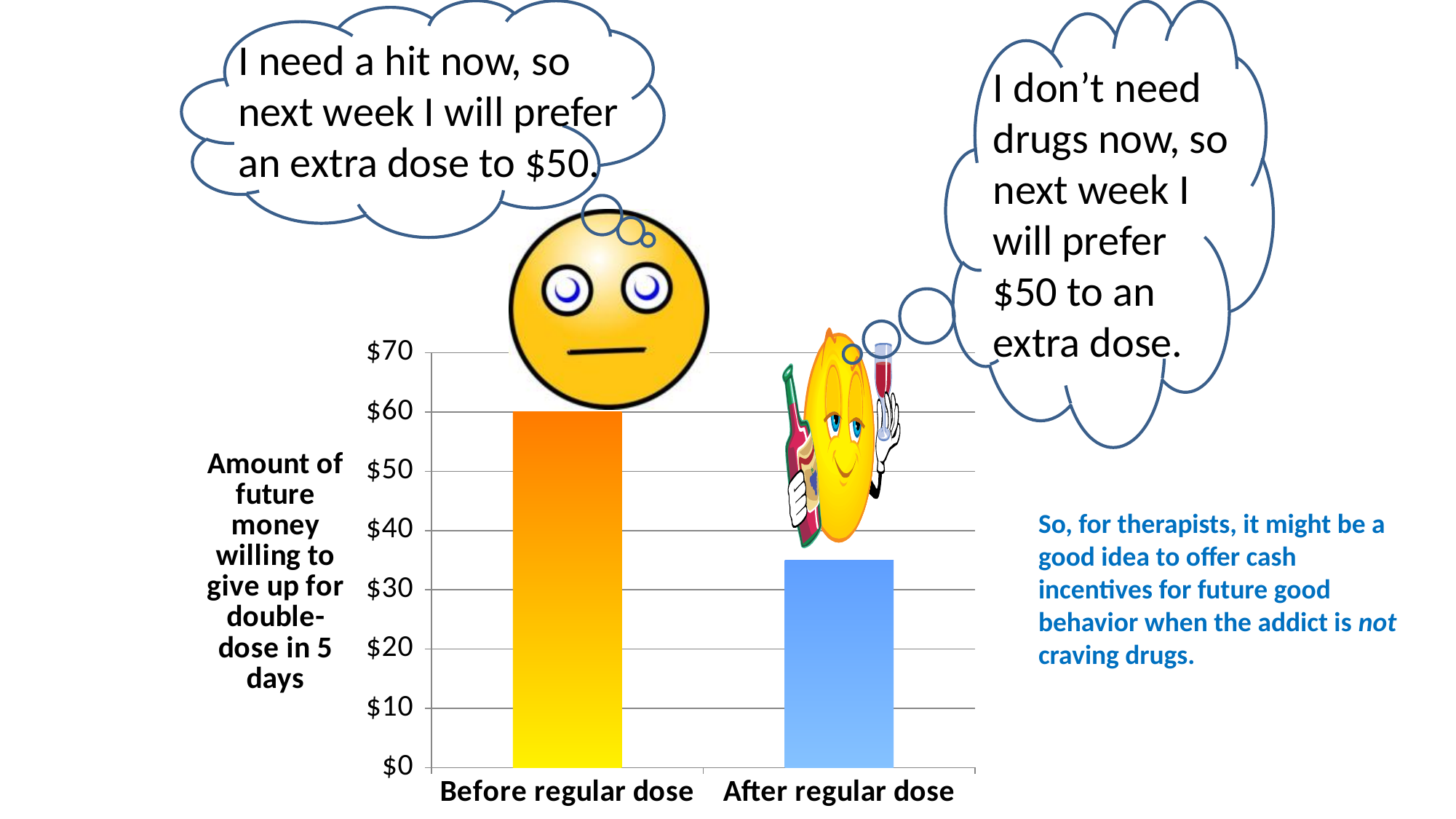
What colour is the bar for "After regular dose"? blue Do the values rise or fall from "Before regular dose" to "After regular dose"? fall How many categories are shown on the x axis of the chart? 2 Which category has the highest bar? Before regular dose Is the value for "After regular dose" greater or less than $30? greater Which category has the lowest bar? After regular dose Is the value for "After regular dose" greater or less than $40? less What is the label on the vertical axis of the chart? Amount of future money willing to give up for double-dose in 5 days Is the value for "Before regular dose" greater or less than $50? greater What kind of chart is shown on the slide? bar chart Which is larger, the value for "Before regular dose" or the value for "After regular dose"? Before regular dose What is the value of the bar for "Before regular dose"? $60